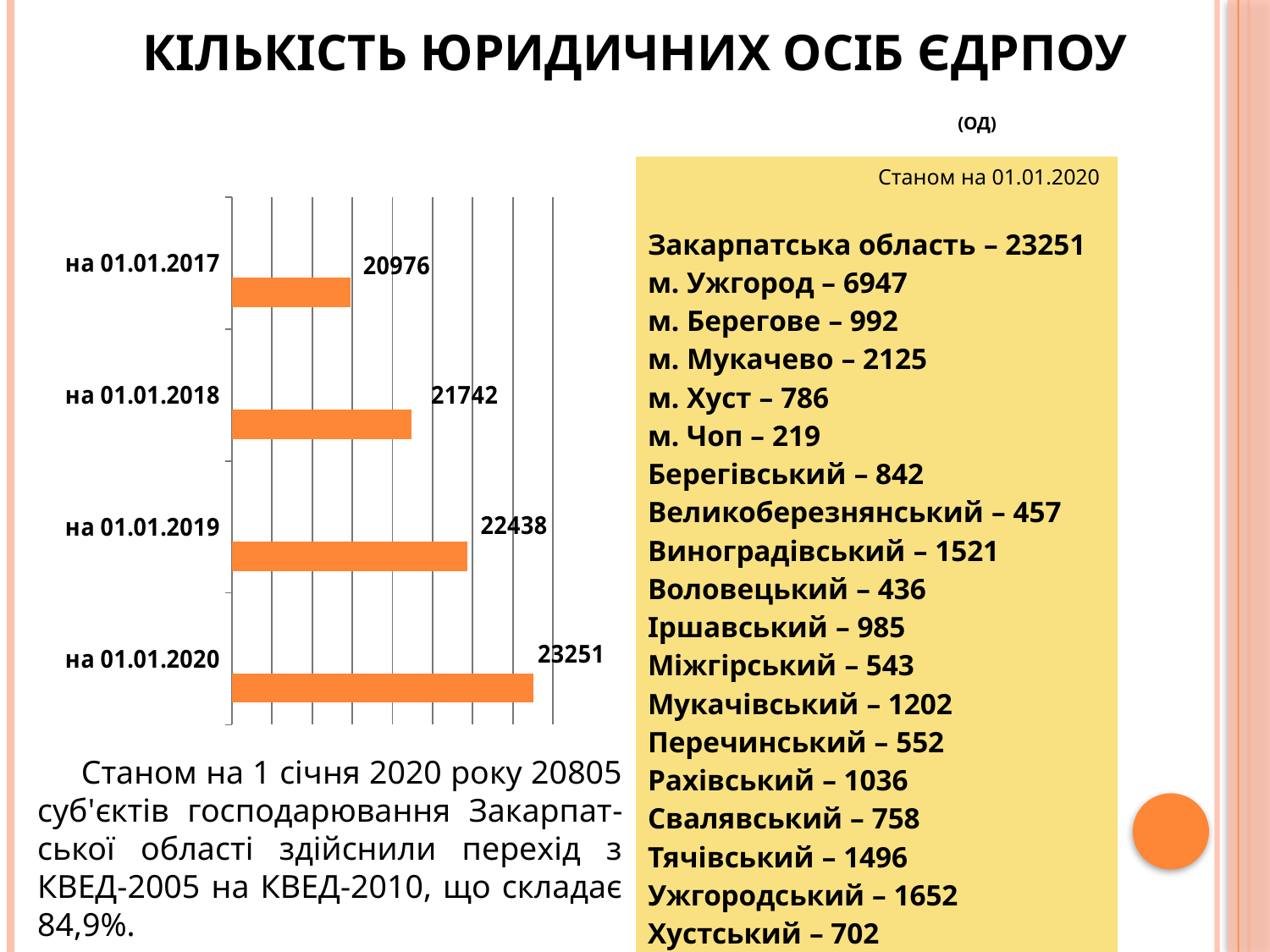
What is the value for на 01.01.2018? 21742 Which date has the highest value in the chart? на 01.01.2020 Do the values rise or fall from на 01.01.2017 to на 01.01.2020? rise Which date has the lowest value in the chart? на 01.01.2017 What type of chart is shown on the slide? bar chart What is the value for на 01.01.2019? 22438 What is the difference between the values for на 01.01.2019 and на 01.01.2018? 696 What is the value for на 01.01.2017? 20976 What is the value for на 01.01.2020? 23251 Which is larger, the value for на 01.01.2018 or the value for на 01.01.2019? на 01.01.2019 How many categories (dates) are plotted in the chart? 4 What is the difference between the values for на 01.01.2020 and на 01.01.2017? 2275